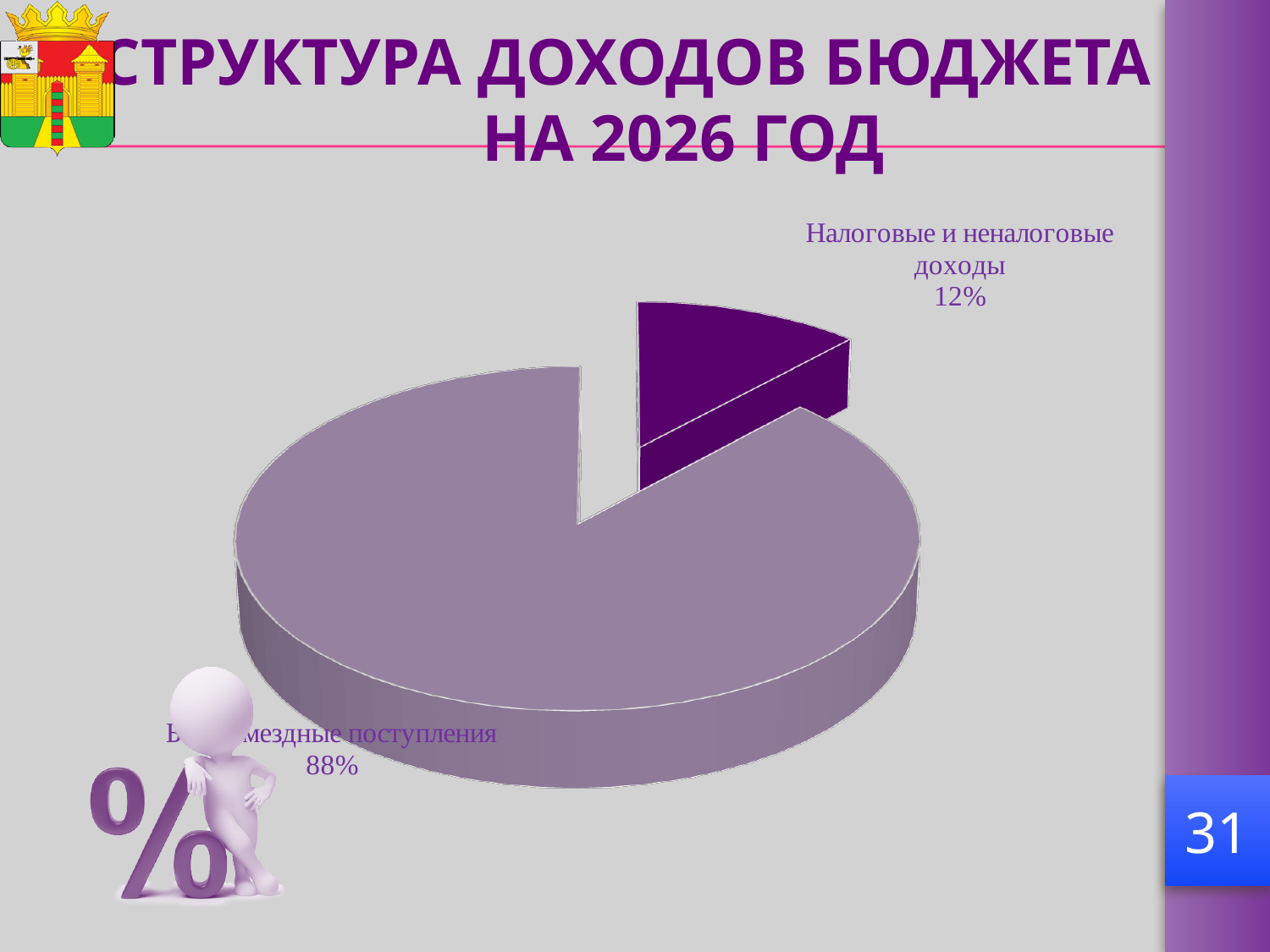
What colour is the slice for "Налоговые и неналоговые доходы"? Dark purple What is the title of the slide? СТРУКТУРА ДОХОДОВ БЮДЖЕТА НА 2026 ГОД What kind of chart is shown on the slide? Pie chart What share of the pie does "Налоговые и неналоговые доходы" represent? 12% What is the value shown for the slice labelled "Безвозмездные поступления"? 88% How many slices does the pie chart have? 2 Which category has the largest slice of the pie? Безвозмездные поступления Which is larger: the share of "Безвозмездные поступления" or the share of "Налоговые и неналоговые доходы"? Безвозмездные поступления What is the value shown for the slice labelled "Налоговые и неналоговые доходы"? 12% What share of the pie does "Безвозмездные поступления" represent? 88% Which category has the smallest slice of the pie? Налоговые и неналоговые доходы What is the difference in percentage points between "Безвозмездные поступления" and "Налоговые и неналоговые доходы"? 76 percentage points